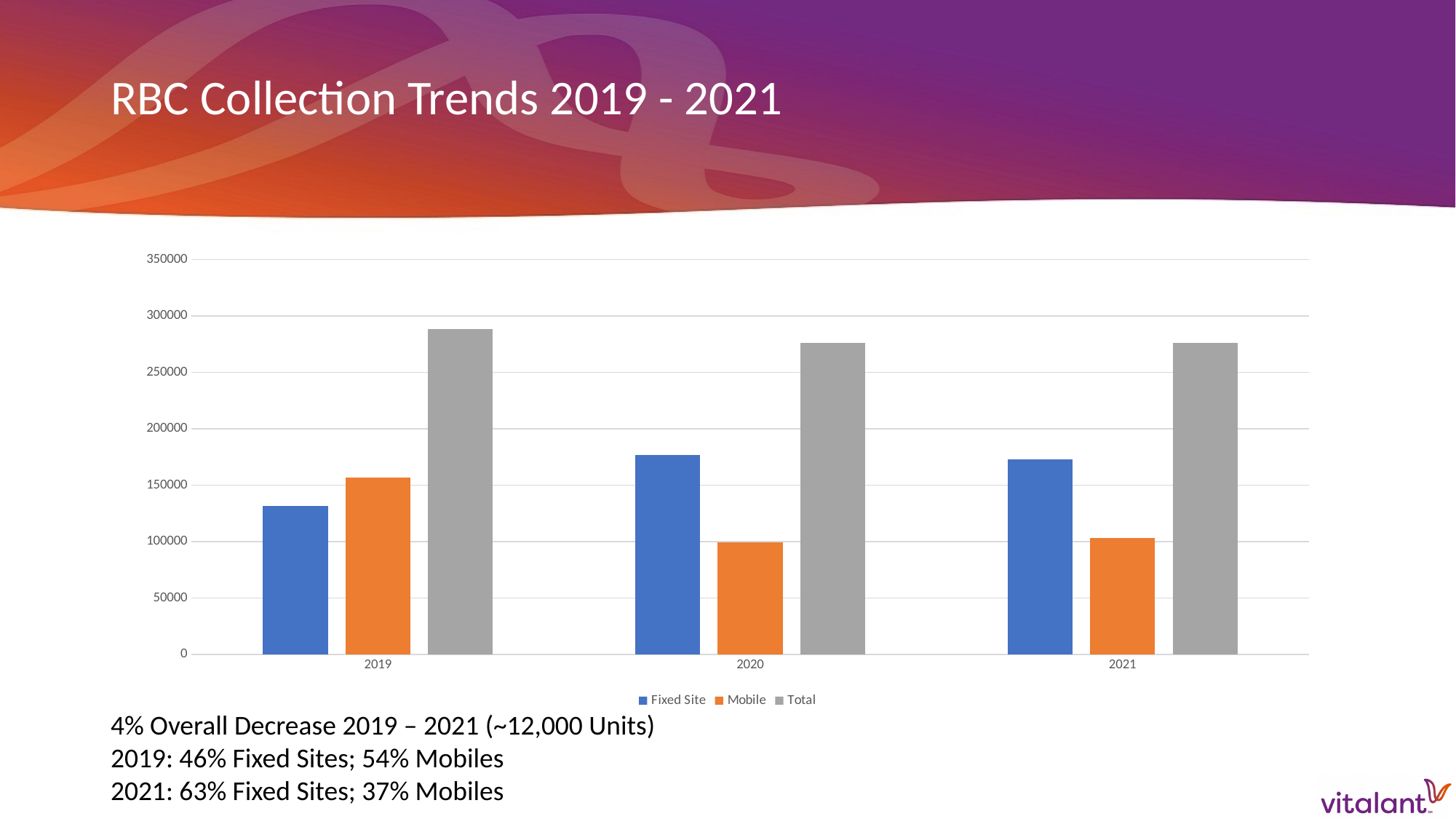
Is the Total value for 2019 greater or less than 300000? less How many series does the legend list? 3 What kind of chart is shown on the slide? bar chart Which year has the lowest Fixed Site bar? 2019 Is the Mobile value for 2019 greater or less than 150000? greater Which year has the highest Total bar? 2019 What colour are the Total bars in the chart? grey From 2019 to 2020, does the Fixed Site value rise or fall? rise How many years are shown on the x axis? 3 In 2019, which is larger, the Fixed Site value or the Mobile value? Mobile Which year has the highest Mobile bar? 2019 In 2021, which is larger, the Fixed Site value or the Mobile value? Fixed Site